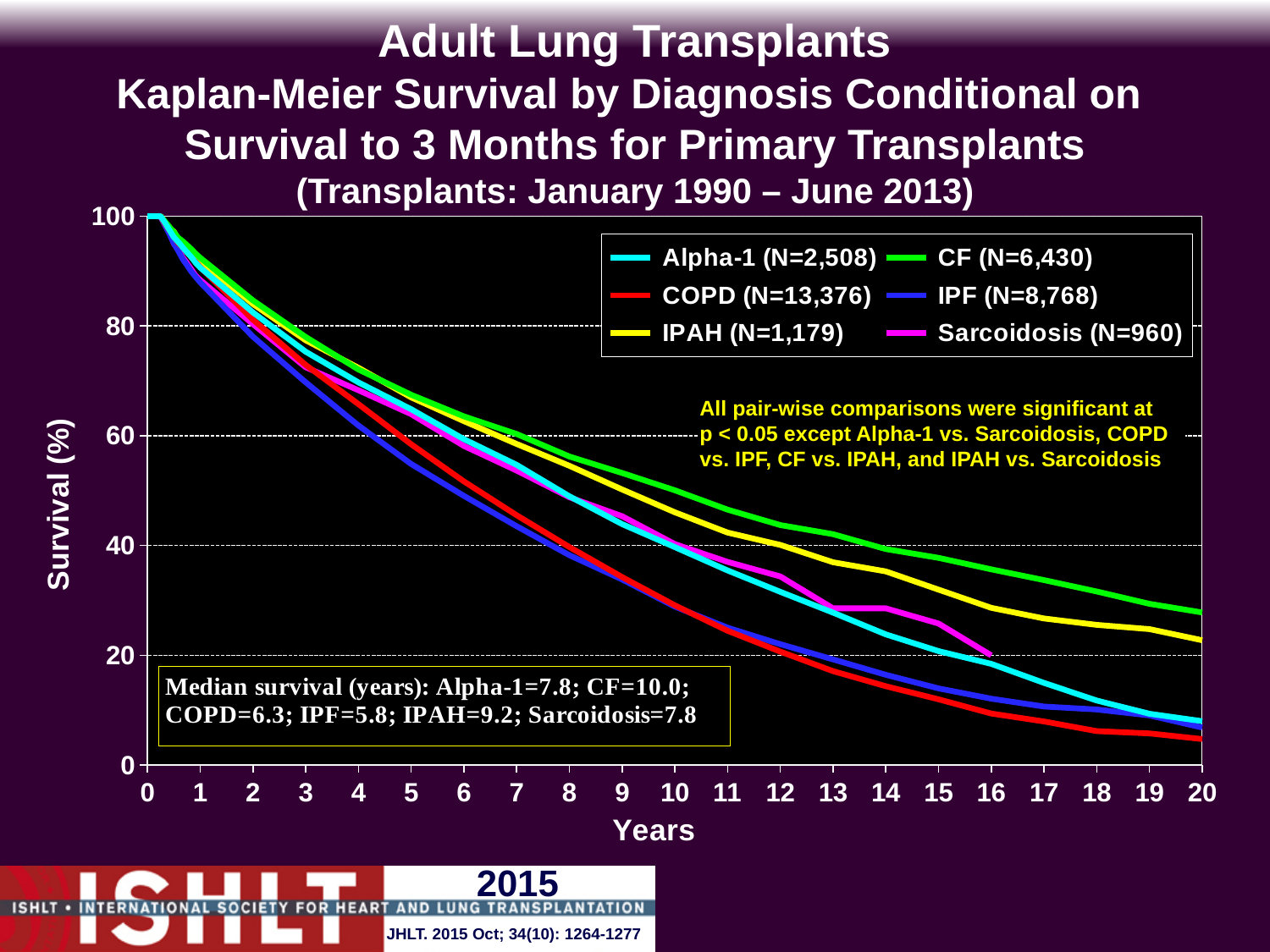
How many series does the legend list? 6 Which diagnosis has the highest survival at 20 years? CF What is the difference in median survival (years) between CF and IPF? 4.2 Is the survival for CF at 20 years greater or less than 20? greater What is the N for COPD shown in the legend? 13,376 What is the median survival in years for IPF according to the text box? 5.8 What kind of chart is shown on the slide? Line chart At 15 years, which has higher survival, IPAH or Alpha-1? IPAH Do the survival curves rise or fall as years increase? Fall Is the survival for COPD at 15 years greater or less than 20? less Is the survival for IPAH at 10 years greater or less than 40? greater Which diagnosis has the lowest survival at 20 years? COPD